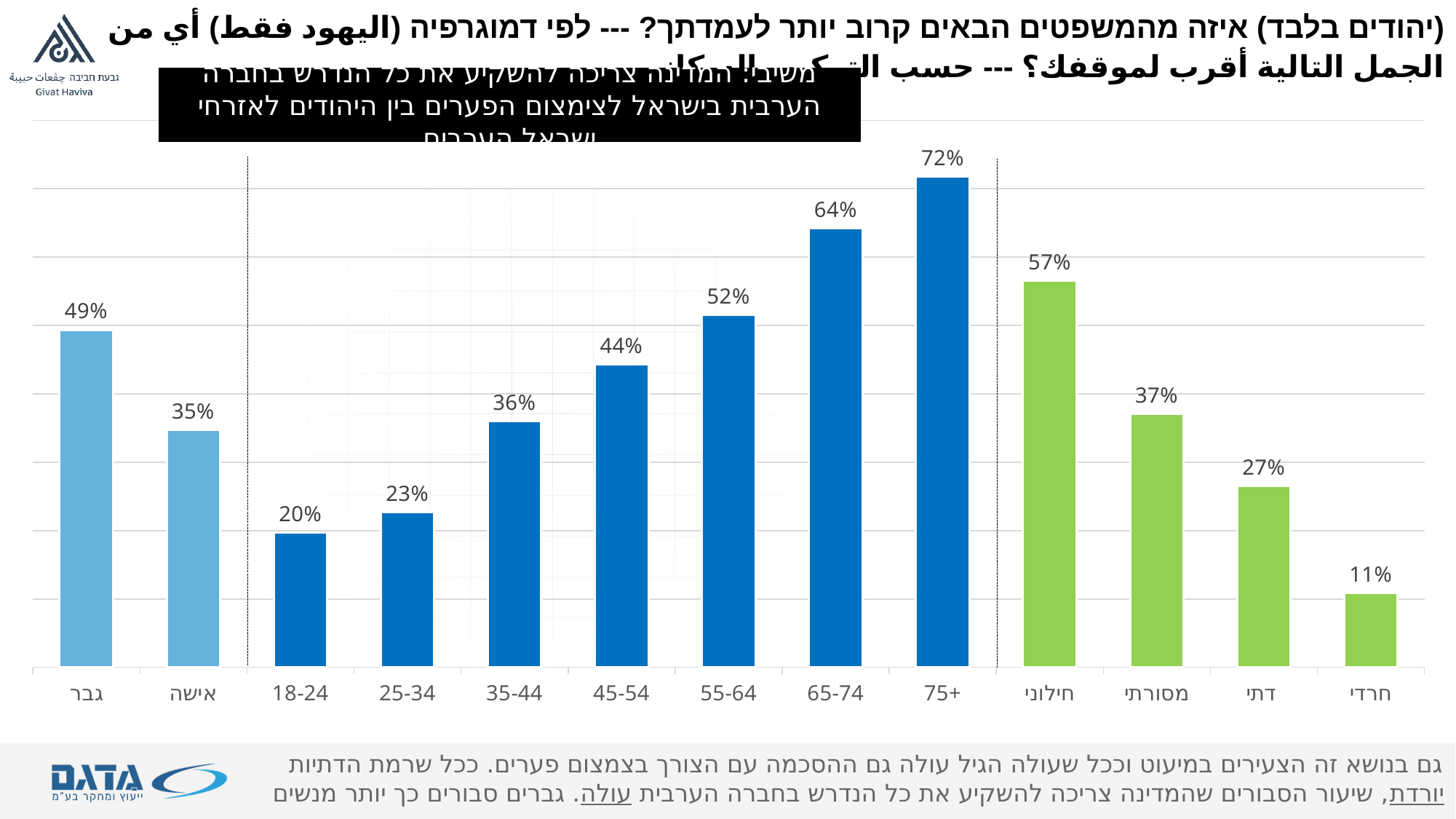
Do the values rise or fall across the age groups from 18-24 to 75+? Rise What is the value for the חילוני category? 57% What kind of chart is shown on the slide? Bar chart How many bars are plotted on the chart? 13 What is the value for the 18-24 age group? 20% What is the value for the גבר category? 49% What is the difference between the values for גבר and אישה? 14% What is the difference between the values for the 65-74 and 55-64 age groups? 12% Which category has the lowest value on the chart? חרדי What is the value for the 75+ age group? 72% Which has a larger value, מסורתי or דתי? מסורתי Which category has the highest value on the chart? 75+